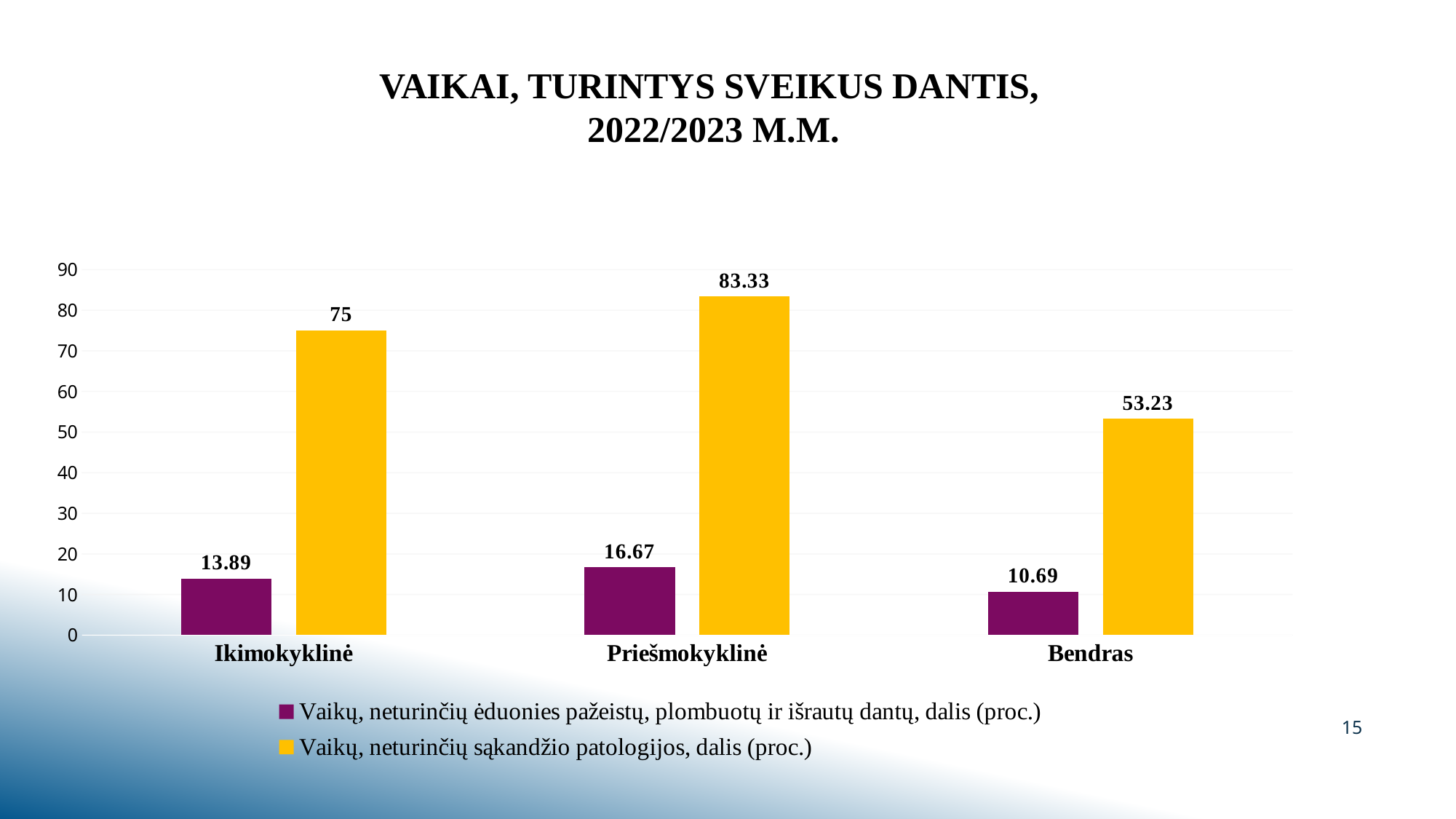
Is the value for Bendras in the series 'Vaikų, neturinčių sąkandžio patologijos, dalis (proc.)' greater or less than 50? greater What is the value for Ikimokyklinė in the series 'Vaikų, neturinčių sąkandžio patologijos, dalis (proc.)'? 75 How many series does the legend list? 2 How many categories are shown on the x axis? 3 What is the value for Bendras in the series 'Vaikų, neturinčių sąkandžio patologijos, dalis (proc.)'? 53.23 What is the title of the chart? VAIKAI, TURINTYS SVEIKUS DANTIS, 2022/2023 M.M. Which category has the lowest value in the series 'Vaikų, neturinčių ėduonies pažeistų, plombuotų ir išrautų dantų, dalis (proc.)'? Bendras What is the value for Priešmokyklinė in the series 'Vaikų, neturinčių ėduonies pažeistų, plombuotų ir išrautų dantų, dalis (proc.)'? 16.67 Which category has the highest value in the series 'Vaikų, neturinčių sąkandžio patologijos, dalis (proc.)'? Priešmokyklinė What is the difference between the two series values for Priešmokyklinė? 66.66 Which is larger: the 'Vaikų, neturinčių ėduonies pažeistų, plombuotų ir išrautų dantų, dalis (proc.)' value for Ikimokyklinė or for Bendras? Ikimokyklinė What kind of chart is shown on the slide? bar chart